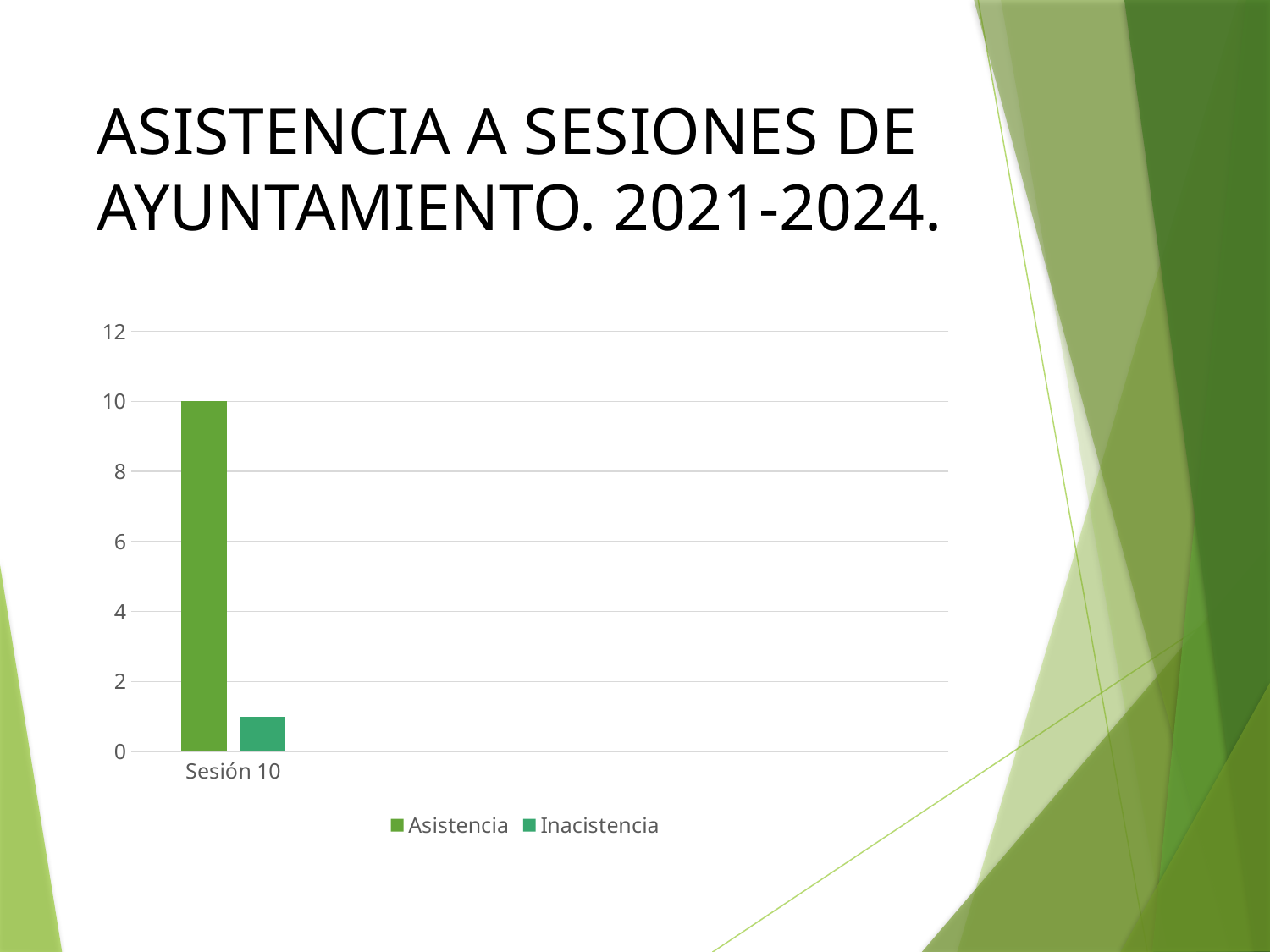
Which series has the lowest bar in the chart? Inacistencia Is the value of Inacistencia for Sesión 10 greater or less than 2? less What are the two entries listed in the legend? Asistencia and Inacistencia Is the value of Asistencia for Sesión 10 greater or less than 8? greater What kind of chart is shown on the slide? bar chart How many series does the legend list? 2 Which series has the highest bar in the chart? Asistencia Which series has the larger value for Sesión 10, Asistencia or Inacistencia? Asistencia What is the label of the category on the x axis? Sesión 10 How many categories are shown on the x axis? 1 Is the value of Inacistencia for Sesión 10 greater or less than 4? less What is the value of Asistencia for Sesión 10? 10